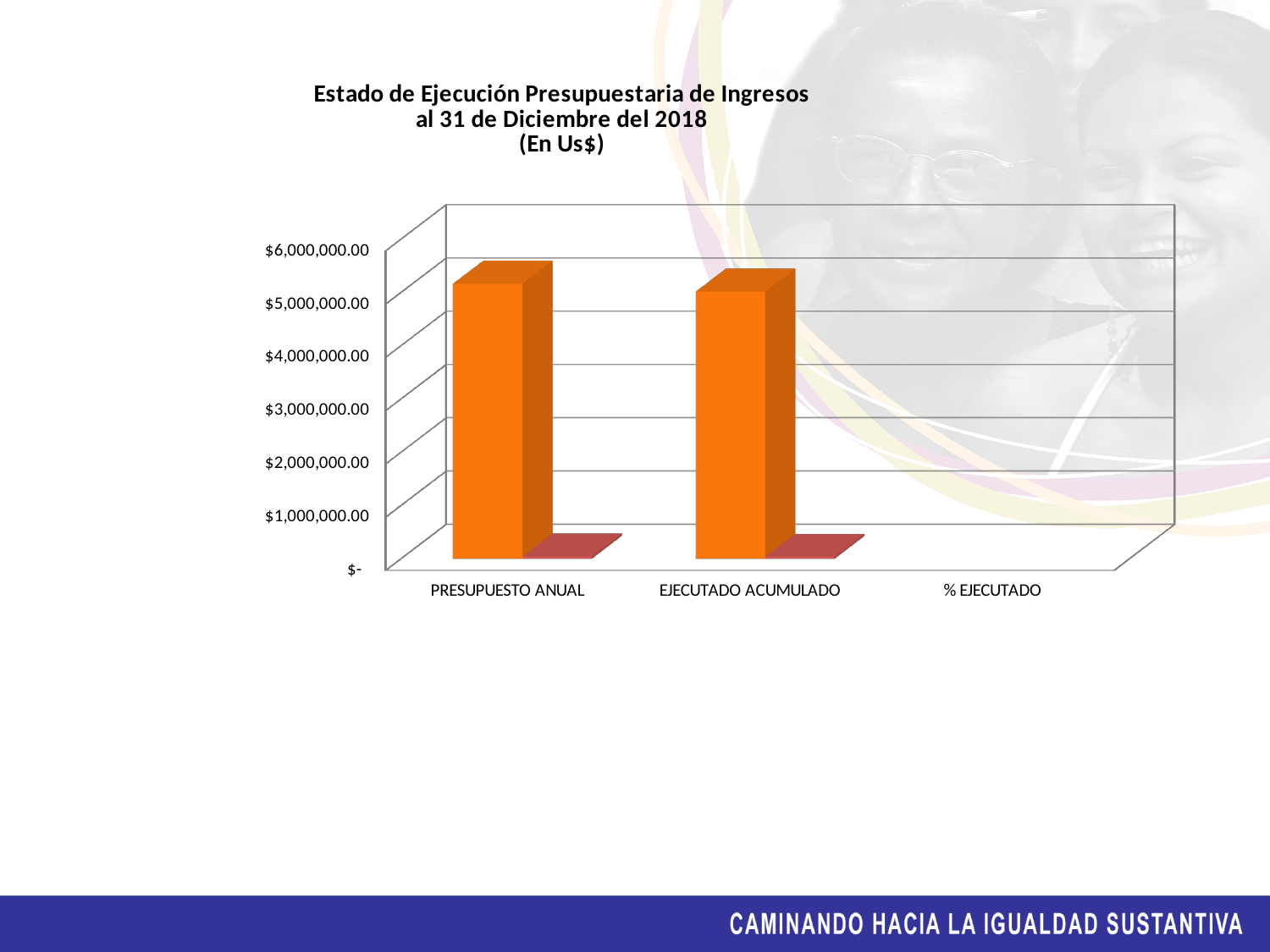
What is the highest value shown on the y axis of the chart? $6,000,000.00 What kind of chart is shown on the slide? bar chart What is the title of the chart? Estado de Ejecución Presupuestaria de Ingresos al 31 de Diciembre del 2018 (En Us$) Is the value for PRESUPUESTO ANUAL greater or less than $5,000,000.00? greater Which category has the lowest value in the chart? % EJECUTADO Which category has the highest value in the chart? PRESUPUESTO ANUAL Is the value for EJECUTADO ACUMULADO greater or less than $6,000,000.00? less Is the value for EJECUTADO ACUMULADO greater or less than $4,000,000.00? greater How many categories are shown on the x axis of the chart? 3 Which is larger, the value for PRESUPUESTO ANUAL or the value for EJECUTADO ACUMULADO? PRESUPUESTO ANUAL